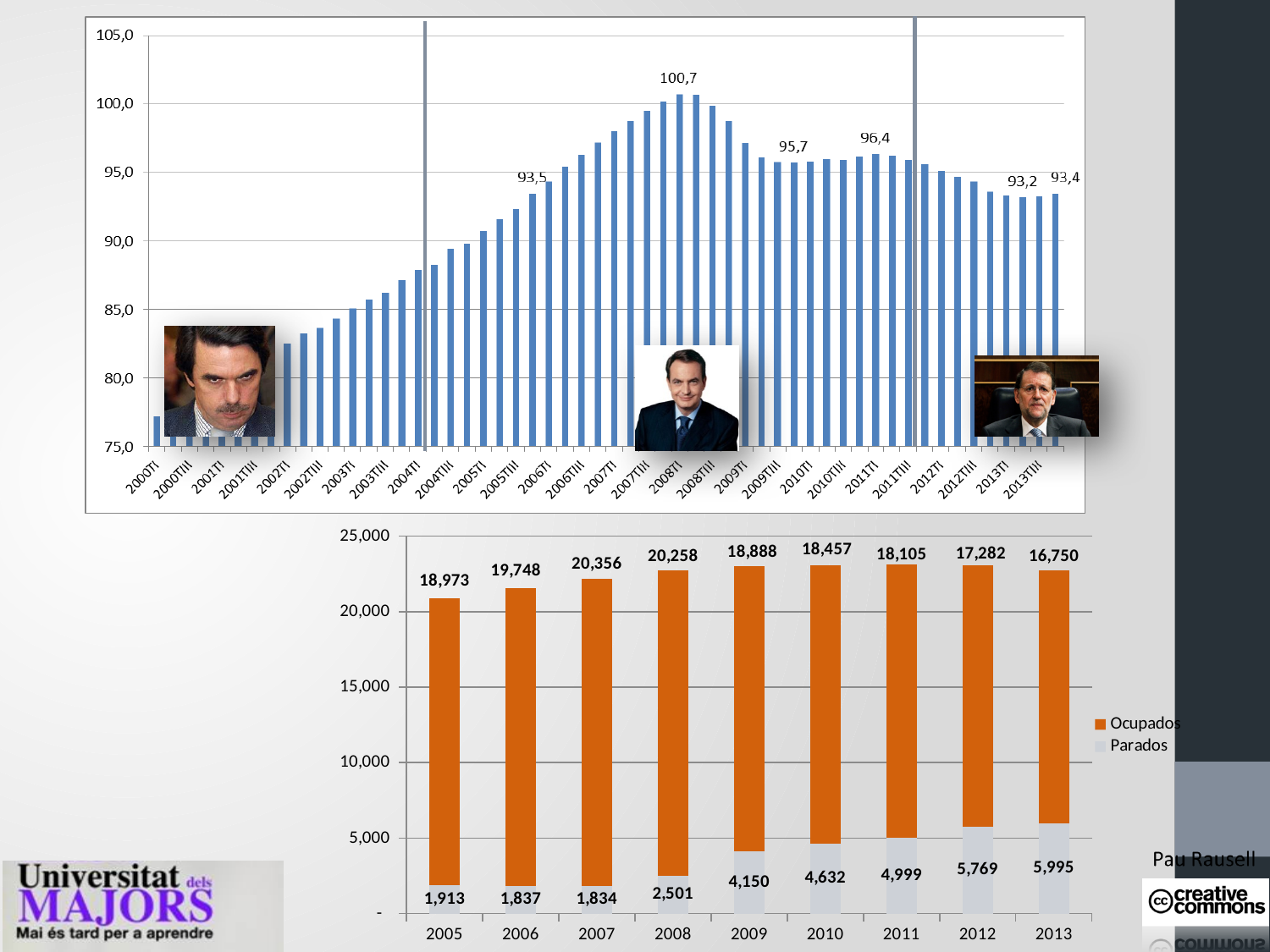
In the bottom chart, is the Parados value larger in 2009 or in 2011? 2011 In the bottom chart, what is the Ocupados value for 2007? 20,356 In the bottom chart, do the Parados values rise or fall from 2008 to 2013? rise In the bottom chart, which year has the lowest Parados value? 2007 In the bottom chart, what is the total of the stacked bar for 2013? 22,745 In the bottom chart, what is the Parados value for 2013? 5,995 In the bottom chart, how many series does the legend list? 2 In the bottom chart, which year has the highest Ocupados value? 2007 In the top chart, what is the highest labelled value? 100,7 What kind of chart is the top chart? bar chart In the bottom chart, what is the difference between the Ocupados values for 2007 and 2013? 3,606 In the bottom chart, how many years are shown on the x axis? 9